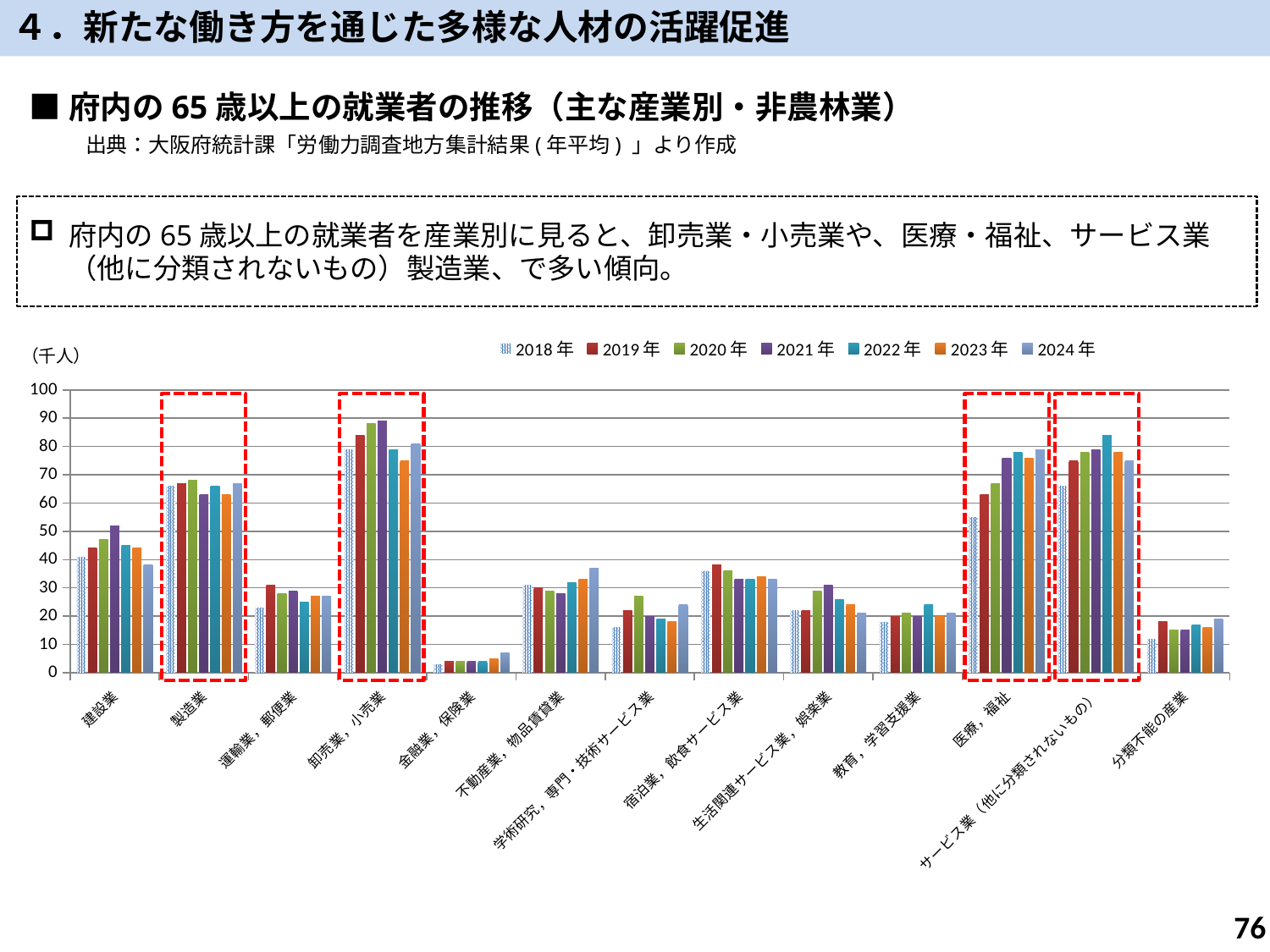
What kind of chart is shown on the slide? bar chart Which is larger in 2021年: 製造業 or 卸売業，小売業? 卸売業，小売業 Which industry category has the lowest bars in the chart? 金融業，保険業 What unit is shown for the y axis of the chart? 千人 Is the value for 医療，福祉 in 2018年 greater or less than 50? greater Which industry category has the tallest bar in the chart? 卸売業，小売業 How many series does the legend list? 7 Which is larger for 医療，福祉: the 2018年 value or the 2024年 value? 2024年 Is the value for 卸売業，小売業 in 2021年 greater or less than 80? greater From 2018年 to 2022年, do the bars for 医療，福祉 rise or fall? rise How many industry categories are shown on the x axis? 13 Is the value for 金融業，保険業 in 2024年 greater or less than 10? less